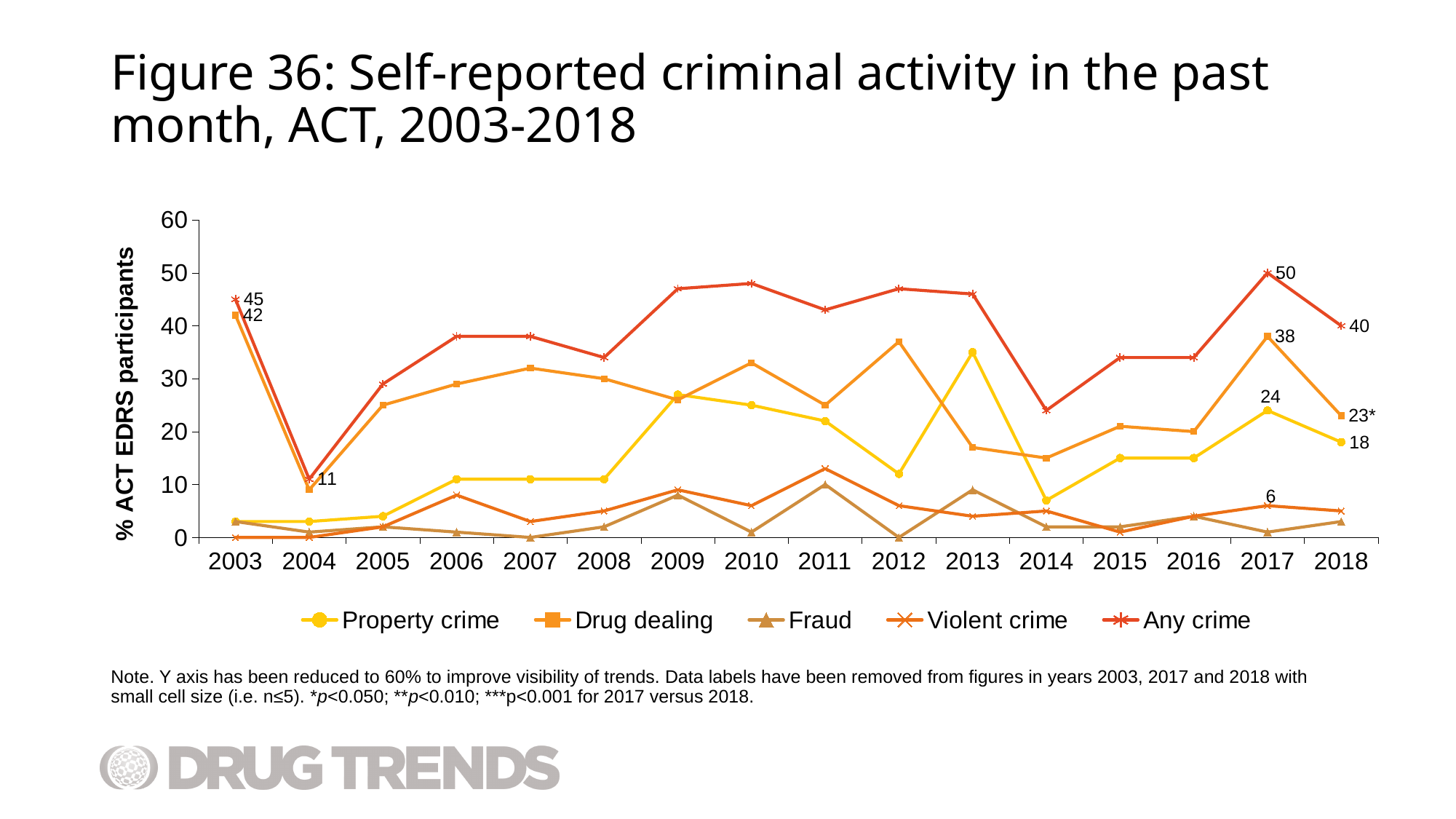
What is the value for Any crime in 2003? 45 How many series does the legend list? 5 In which year is the Any crime series at its highest? 2017 How many years are shown on the x axis? 16 What is the value for Any crime in 2017? 50 Is the value for Any crime in 2010 greater or less than 40? greater What is the difference between the Any crime values in 2017 and 2018? 10 In 2017, which is larger: Drug dealing or Property crime? Drug dealing What is the value for Drug dealing in 2017? 38 What kind of chart is shown on the slide? line chart What is the value for Any crime in 2018? 40 What is the value for Property crime in 2018? 18